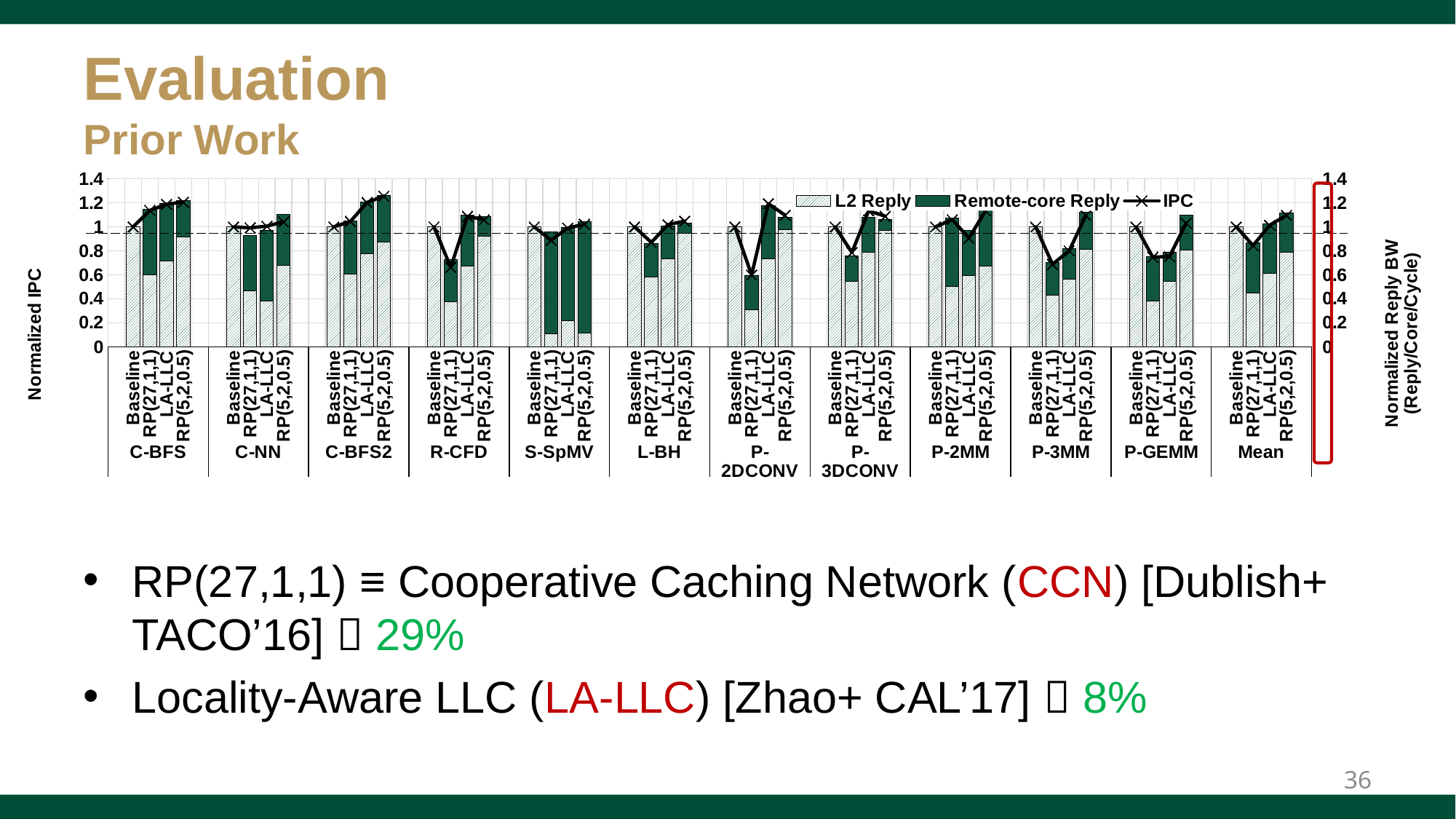
Is the IPC value for RP(5,2,0.5) in the C-BFS2 group greater or less than 1? greater How many configurations are plotted within each benchmark group? 4 What is the title of the right-hand vertical axis? Normalized Reply BW (Reply/Core/Cycle) Which has the higher IPC: RP(27,1,1) in the C-BFS group or RP(27,1,1) in the R-CFD group? RP(27,1,1) in C-BFS What kind of chart is shown on the slide? Stacked bar chart with a line (IPC) overlay Is the IPC value for RP(27,1,1) in the Mean group greater or less than 1? less What are the three entries in the chart legend? L2 Reply, Remote-core Reply, IPC How many series does the chart legend list? 3 Is the IPC value for RP(27,1,1) in the R-CFD group greater or less than 0.8? less How many benchmark groups (including Mean) are shown along the x axis? 12